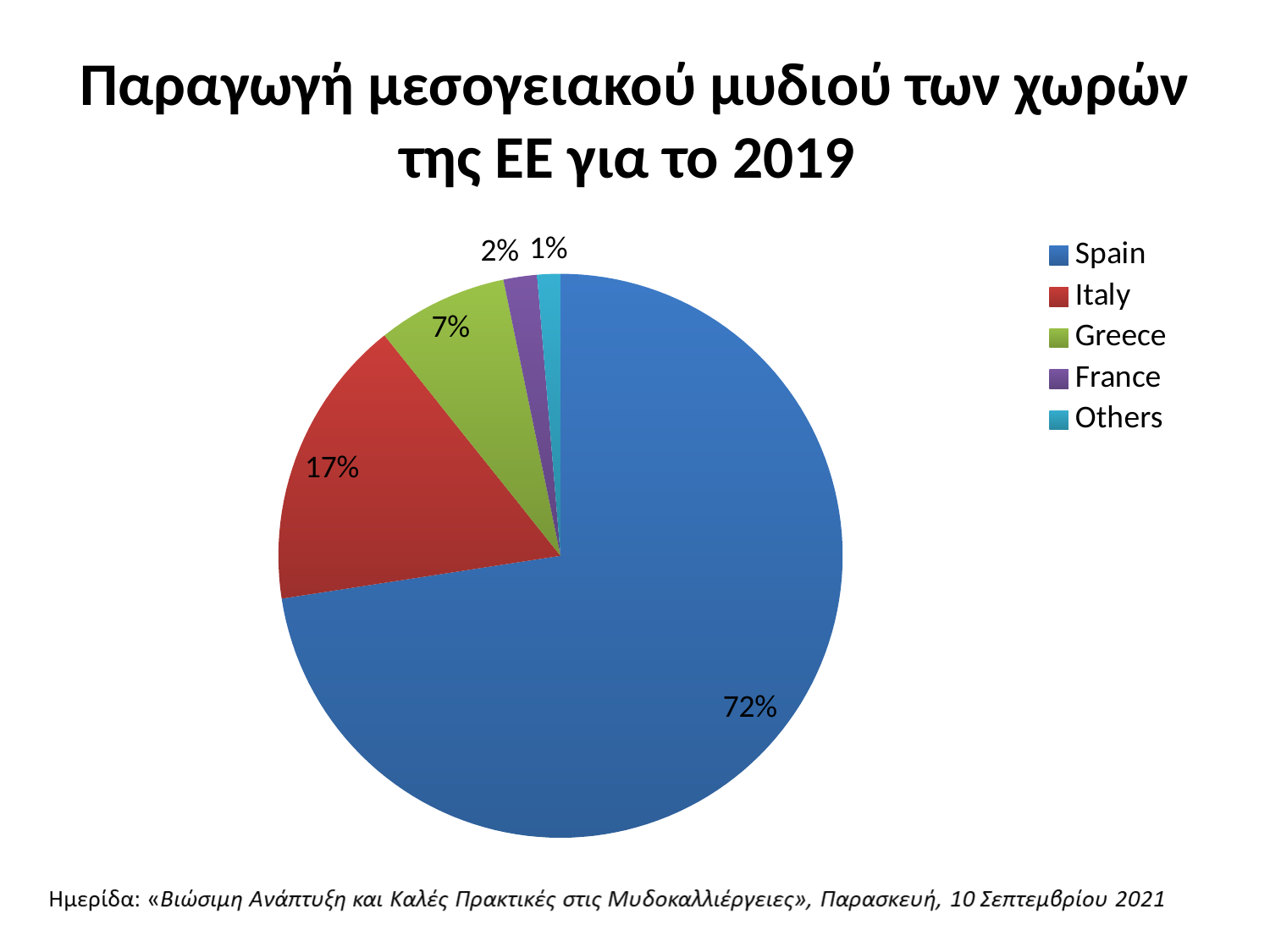
Which has a larger share, Greece or France? Greece What is the difference in percentage points between Spain's share and Italy's share? 55 Which legend entry has the smallest slice of the pie? Others What share of the pie does Spain have? 72% What colour is the slice for Italy? red What share of the pie does Greece have? 7% What share of the pie does Others have? 1% Which country has the largest slice of the pie? Spain What kind of chart is shown on the slide? pie chart How many entries does the legend list? 5